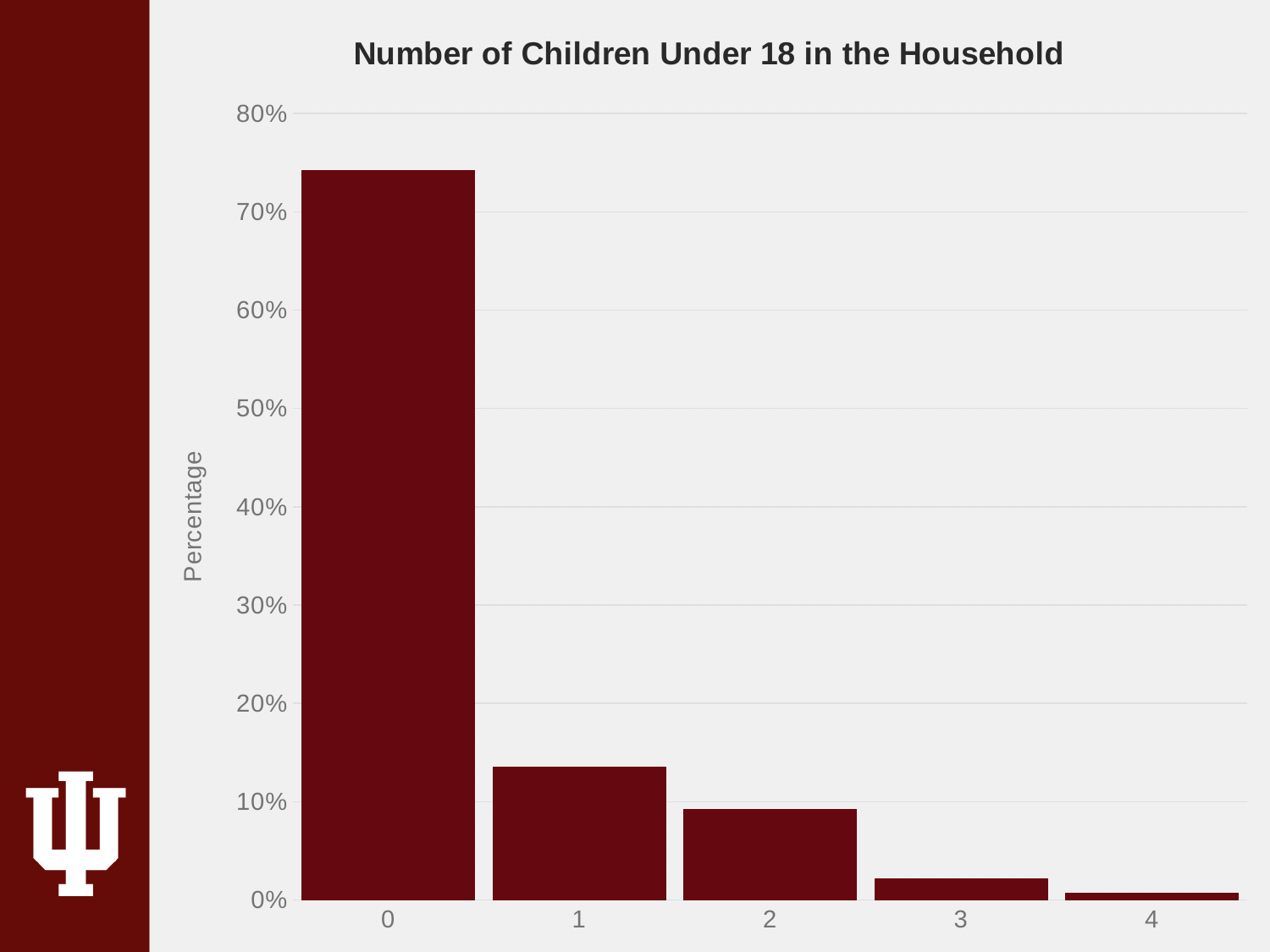
Do the values rise or fall as the number of children increases along the x axis? fall Which is larger, the value for 1 child or the value for 2 children? 1 What type of chart is shown on the slide? bar chart How many categories are shown on the x axis? 5 Is the value for 1 child greater or less than 10%? greater Which category has the highest percentage? 0 Is the value for 2 children greater or less than 10%? less What is the title of the chart? Number of Children Under 18 in the Household Is the value for 0 children greater or less than 70%? greater Which category has the lowest percentage? 4 What is the label on the vertical axis? Percentage